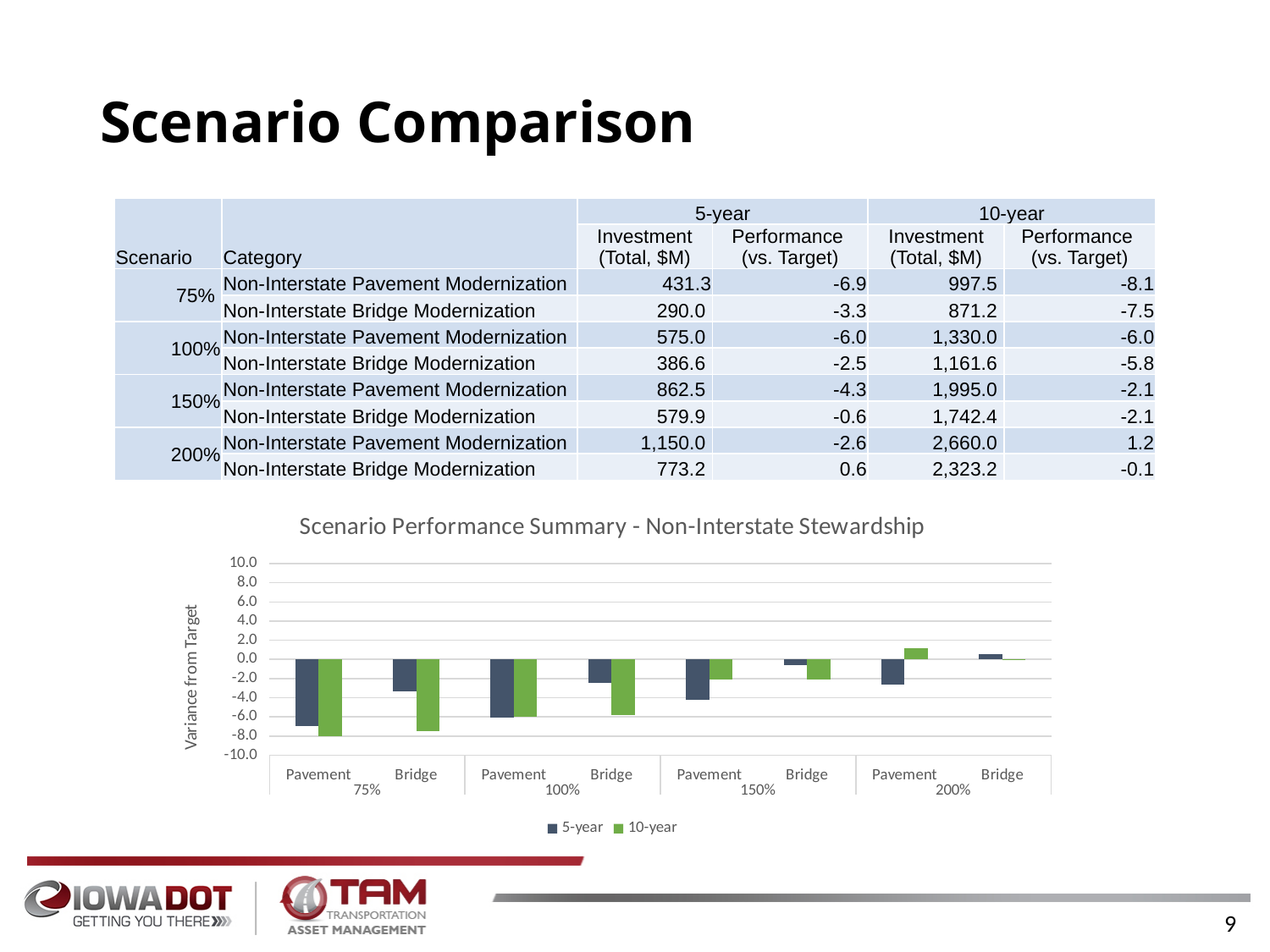
Do the 10-year Pavement values rise or fall as the scenario moves from 75% to 200%? rise Is the 5-year value for Bridge in the 100% scenario greater or less than -4.0? greater What is the title of the chart? Scenario Performance Summary - Non-Interstate Stewardship How many series does the chart legend list? 2 What is the label of the chart's vertical axis? Variance from Target Which category has the highest 10-year value in the chart? Pavement (200%) Is the 10-year value for Bridge in the 75% scenario greater or less than -6.0? less What kind of chart is shown on the slide? bar chart Is the 5-year value for Pavement in the 75% scenario greater or less than -6.0? less How many scenario groups are shown along the x axis of the chart? 4 Which category has the lowest 10-year value in the chart? Pavement (75%) For Pavement in the 150% scenario, which series has the larger value, 5-year or 10-year? 10-year